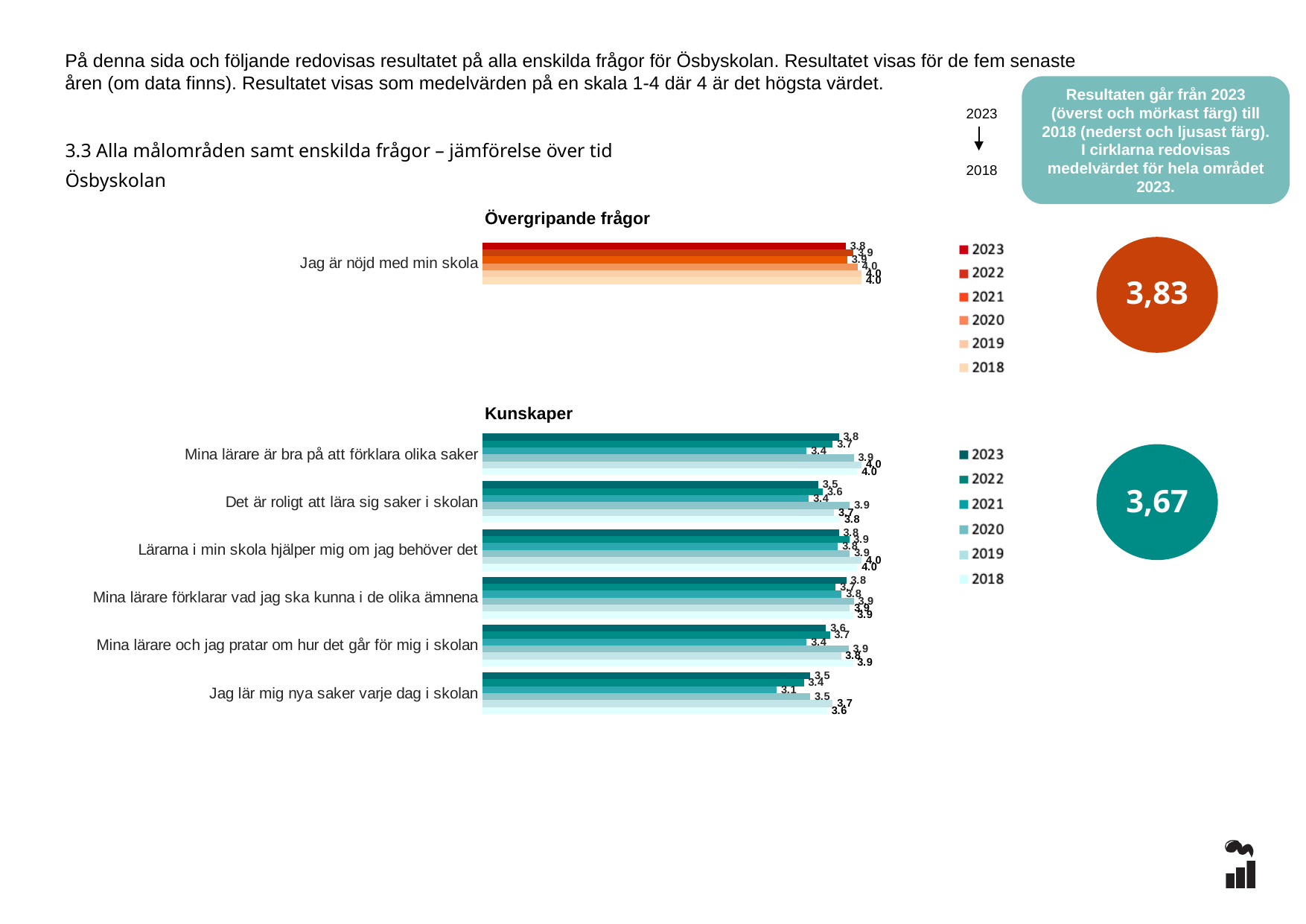
What mean value for 2023 is shown in the circle next to the 'Kunskaper' chart? 3,67 In the 'Kunskaper' chart, which question has the lowest 2021 value? Jag lär mig nya saker varje dag i skolan What type of chart is used in the 'Kunskaper' chart? bar chart What mean value for 2023 is shown in the circle next to the 'Övergripande frågor' chart? 3,83 In the 'Kunskaper' chart, which has the larger 2021 value: 'Mina lärare är bra på att förklara olika saker' or 'Jag lär mig nya saker varje dag i skolan'? Mina lärare är bra på att förklara olika saker In the 'Kunskaper' chart, how many questions (categories) are listed? 6 How many years (series) does the legend of the 'Kunskaper' chart list? 6 In the 'Övergripande frågor' chart, what is the 2023 value for 'Jag är nöjd med min skola'? 3,8 In the 'Kunskaper' chart, what is the 2021 value for 'Jag lär mig nya saker varje dag i skolan'? 3,1 In the 'Kunskaper' chart, what is the difference between the 2021 values for 'Mina lärare är bra på att förklara olika saker' and 'Jag lär mig nya saker varje dag i skolan'? 0,3 In the 'Kunskaper' chart, what is the 2021 value for 'Mina lärare är bra på att förklara olika saker'? 3,4 In the 'Kunskaper' chart, what is the 2023 value for 'Det är roligt att lära sig saker i skolan'? 3,5